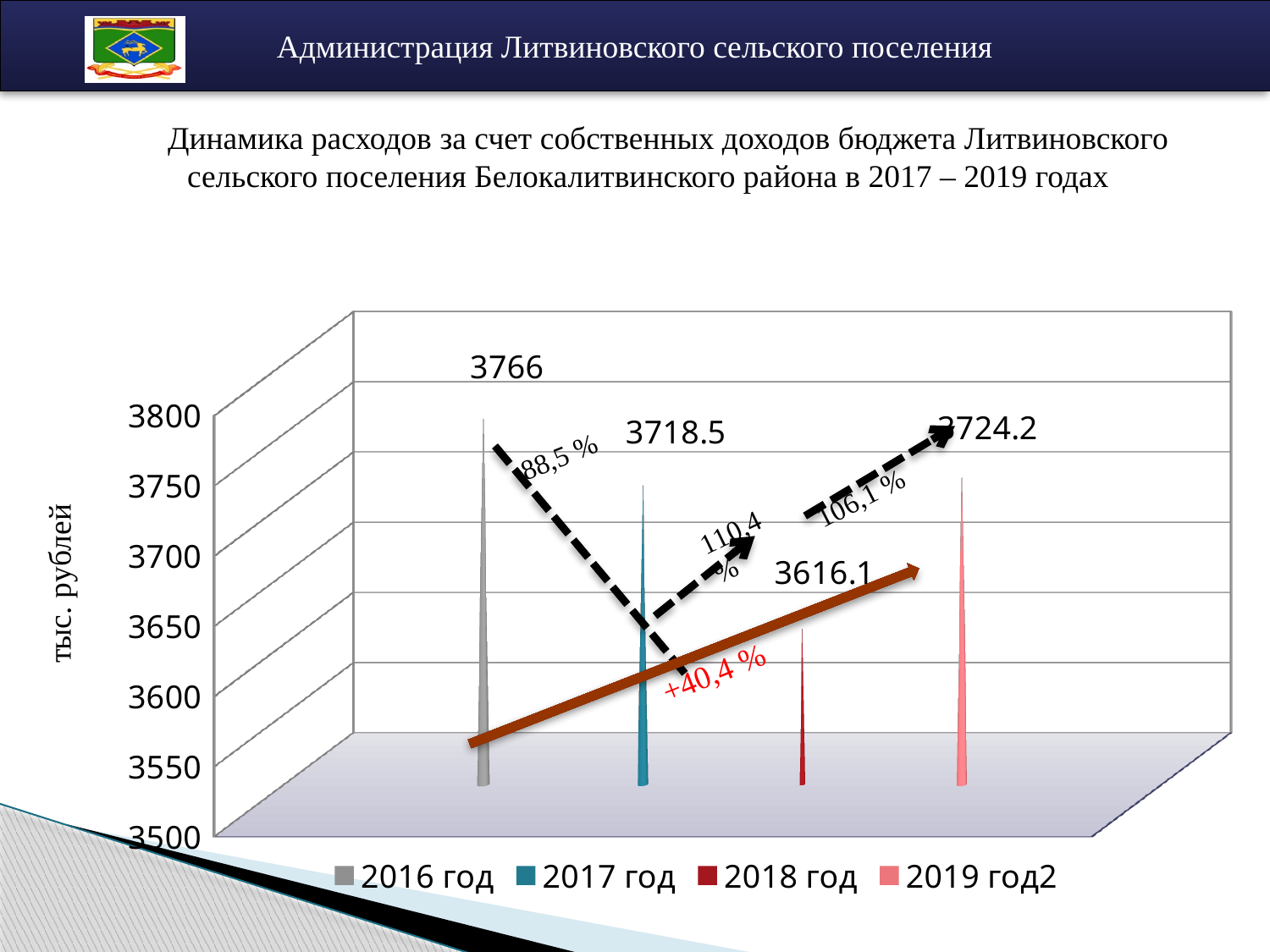
How many series does the legend list? 4 What colour is the 2017 год series in the legend? Teal What is the value for 2018 год? 3616.1 What is the value for 2016 год? 3766 What is the value for 2017 год? 3718.5 Which is larger, the value for 2017 год or the value for 2019 год2? 2019 год2 What is the label of the vertical axis? тыс. рублей What is the value for 2019 год2? 3724.2 What is the difference between the values for 2016 год and 2018 год? 149.9 Which year has the highest value? 2016 год Which year has the lowest value? 2018 год Is the value for 2018 год greater or less than 3650? less